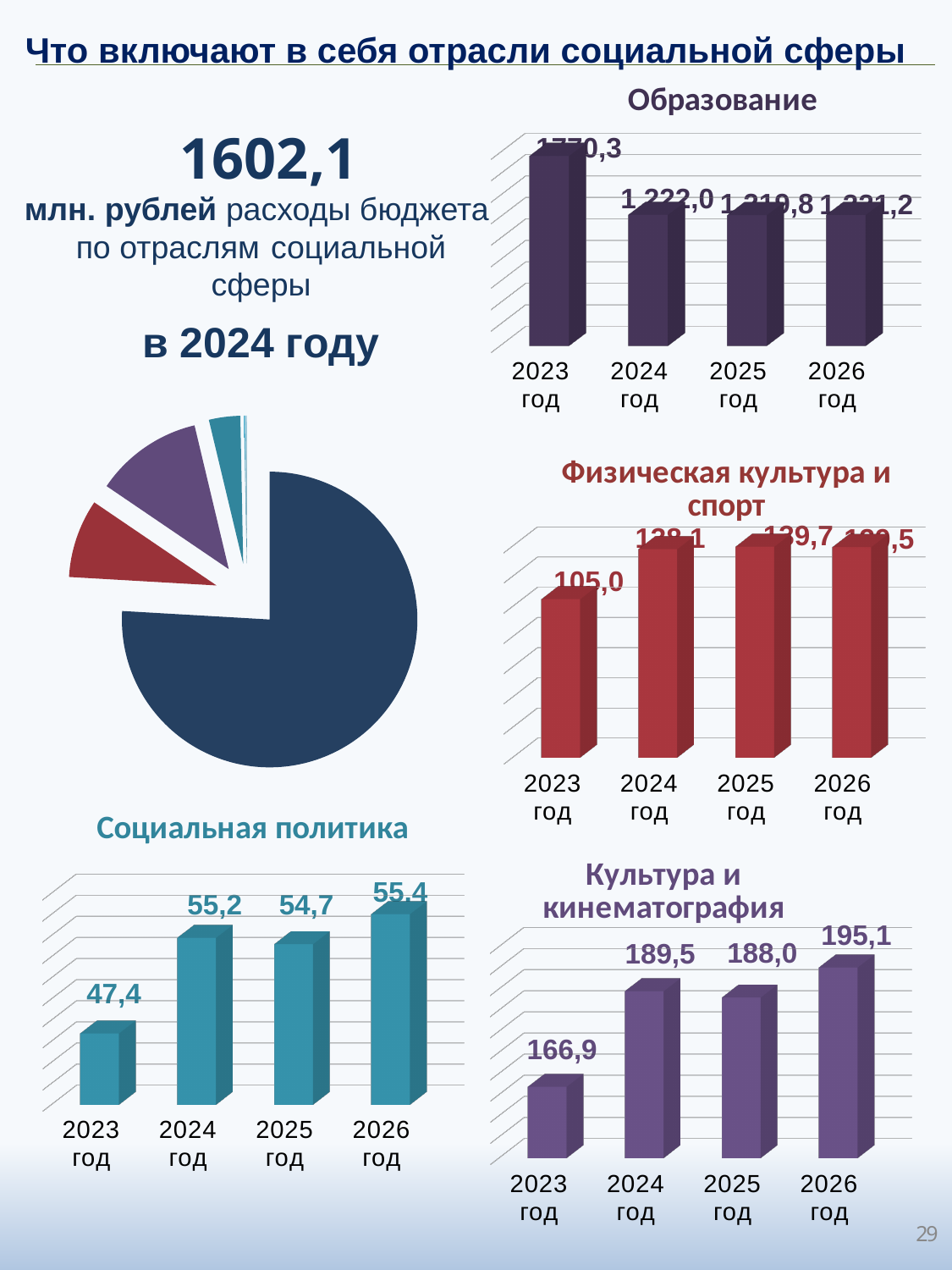
In the 'Социальная политика' chart, how many years are shown on the x axis? 4 In the 'Образование' chart, which year has the highest value? 2023 год In the 'Культура и кинематография' chart, which is larger, the value for 2024 год or 2025 год? 2024 год In the 'Культура и кинематография' chart, what is the difference between the values for 2026 год and 2025 год? 7,1 In the 'Культура и кинематография' chart, what is the value for 2026 год? 195,1 In the 'Культура и кинематография' chart, which year has the lowest value? 2023 год In the 'Социальная политика' chart, which year has the highest value? 2026 год In the 'Социальная политика' chart, what is the difference between the values for 2024 год and 2023 год? 7,8 In the 'Физическая культура и спорт' chart, what is the value for 2023 год? 105,0 What kind of chart is the 'Образование' chart? bar chart In the 'Социальная политика' chart, what is the value for 2023 год? 47,4 In the 'Физическая культура и спорт' chart, which year has the lowest value? 2023 год